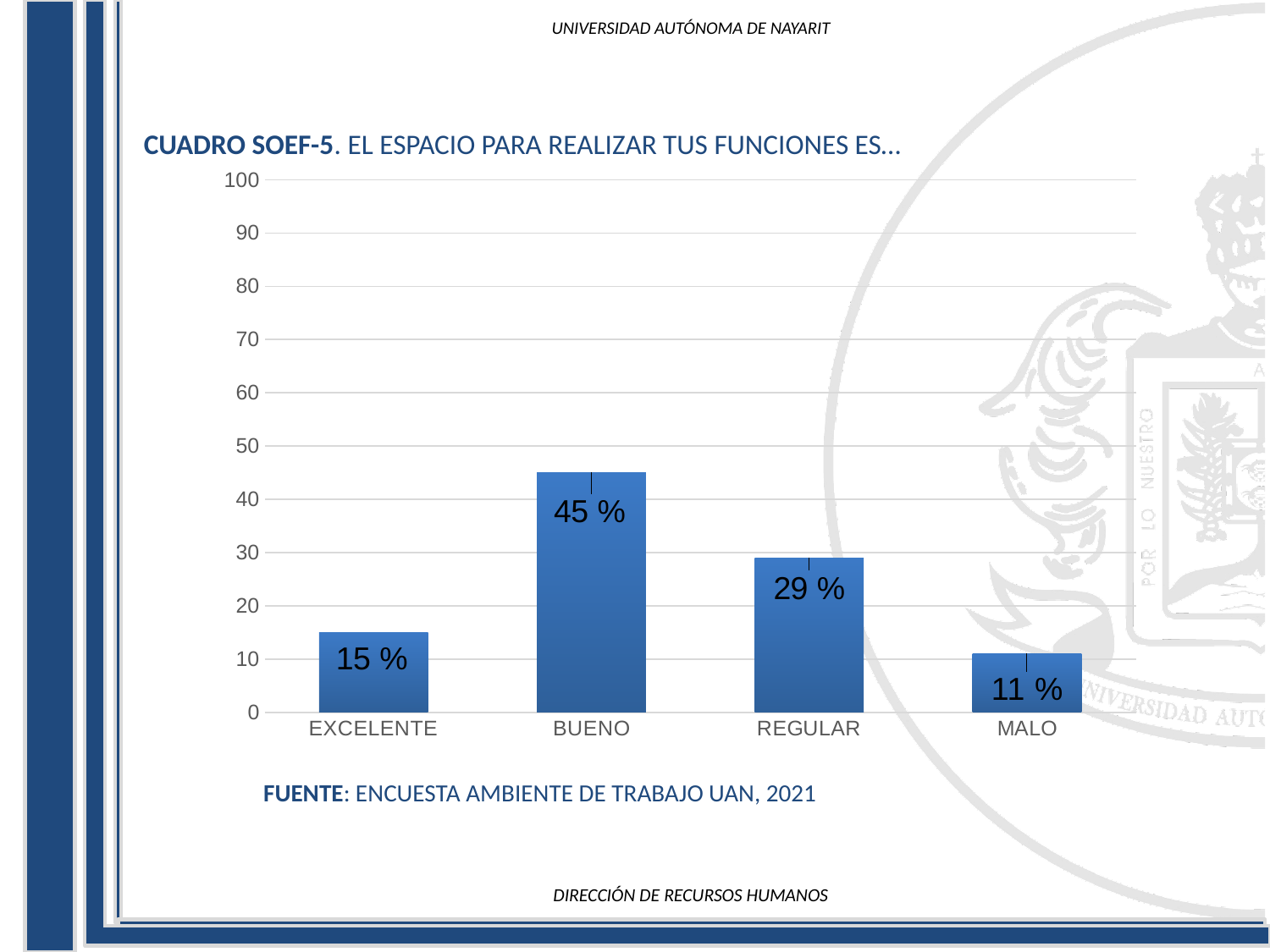
What is the value for BUENO? 45 % How many categories are shown on the x axis? 4 Which category has the lowest value? MALO Which is larger, the value for EXCELENTE or the value for REGULAR? REGULAR What is the highest value shown on the y axis? 100 What is the value for MALO? 11 % What is the difference between the values for BUENO and REGULAR? 16 % What kind of chart is shown on the slide? bar chart Which category has the highest value? BUENO What is the value for EXCELENTE? 15 % What is the source cited below the chart? ENCUESTA AMBIENTE DE TRABAJO UAN, 2021 Is the value for REGULAR greater or less than 20? greater